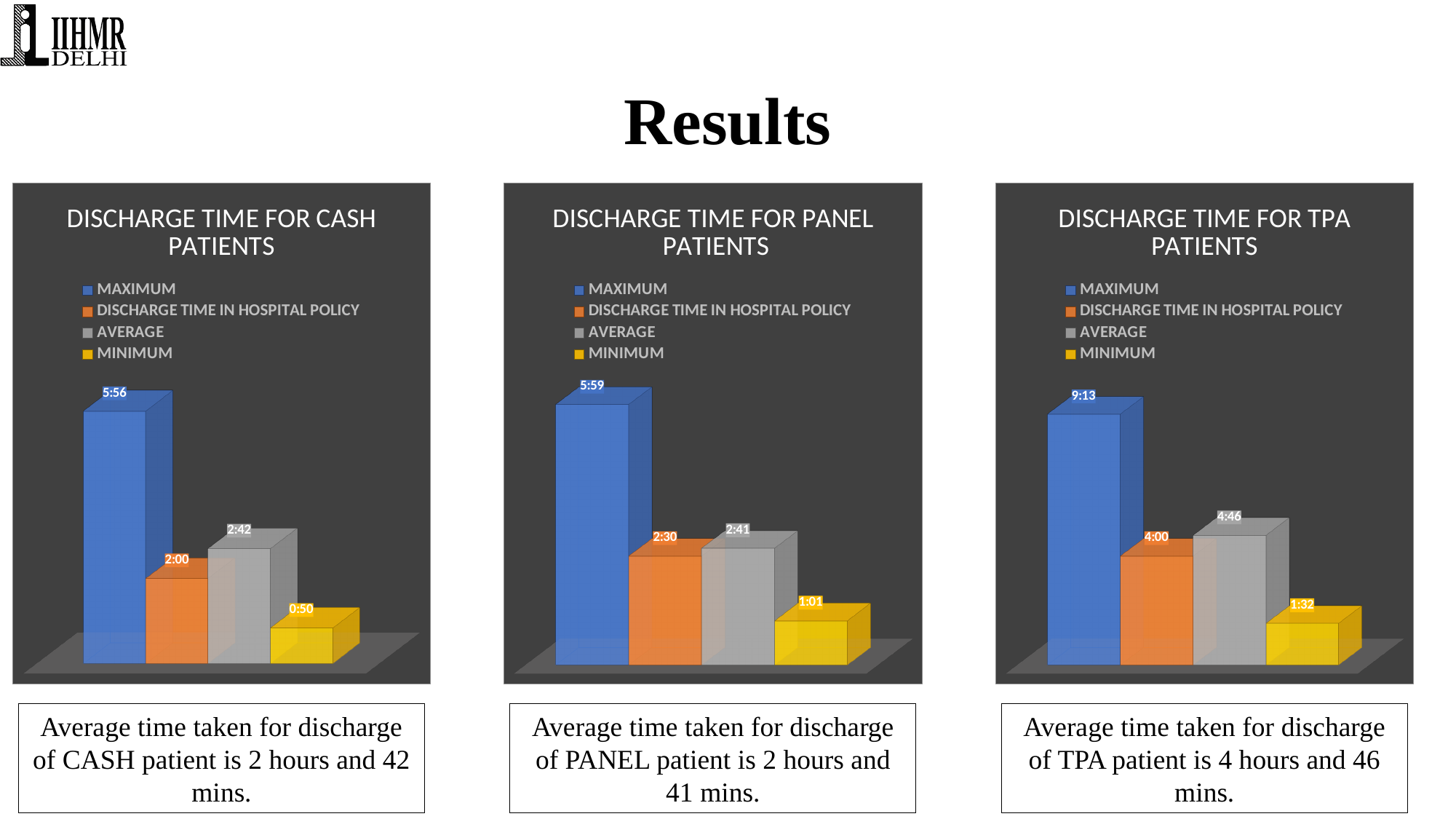
In the 'Discharge Time for TPA Patients' chart, what is the value for DISCHARGE TIME IN HOSPITAL POLICY? 4:00 In the 'Discharge Time for Cash Patients' chart, what is the value for MAXIMUM? 5:56 In the 'Discharge Time for Cash Patients' chart, which series has the lowest value? MINIMUM In the 'Discharge Time for TPA Patients' chart, what is the value for MINIMUM? 1:32 In the 'Discharge Time for Cash Patients' chart, what colour is the MINIMUM bar? Yellow In the 'Discharge Time for Cash Patients' chart, which is larger: AVERAGE or DISCHARGE TIME IN HOSPITAL POLICY? AVERAGE What kind of chart is 'Discharge Time for TPA Patients'? Bar chart In the 'Discharge Time for TPA Patients' chart, which series has the highest value? MAXIMUM In the 'Discharge Time for Panel Patients' chart, which is larger: DISCHARGE TIME IN HOSPITAL POLICY or AVERAGE? AVERAGE How many series does the legend of the 'Discharge Time for Panel Patients' chart list? 4 How many charts are shown on the slide? 3 In the 'Discharge Time for Panel Patients' chart, what is the value for AVERAGE? 2:41